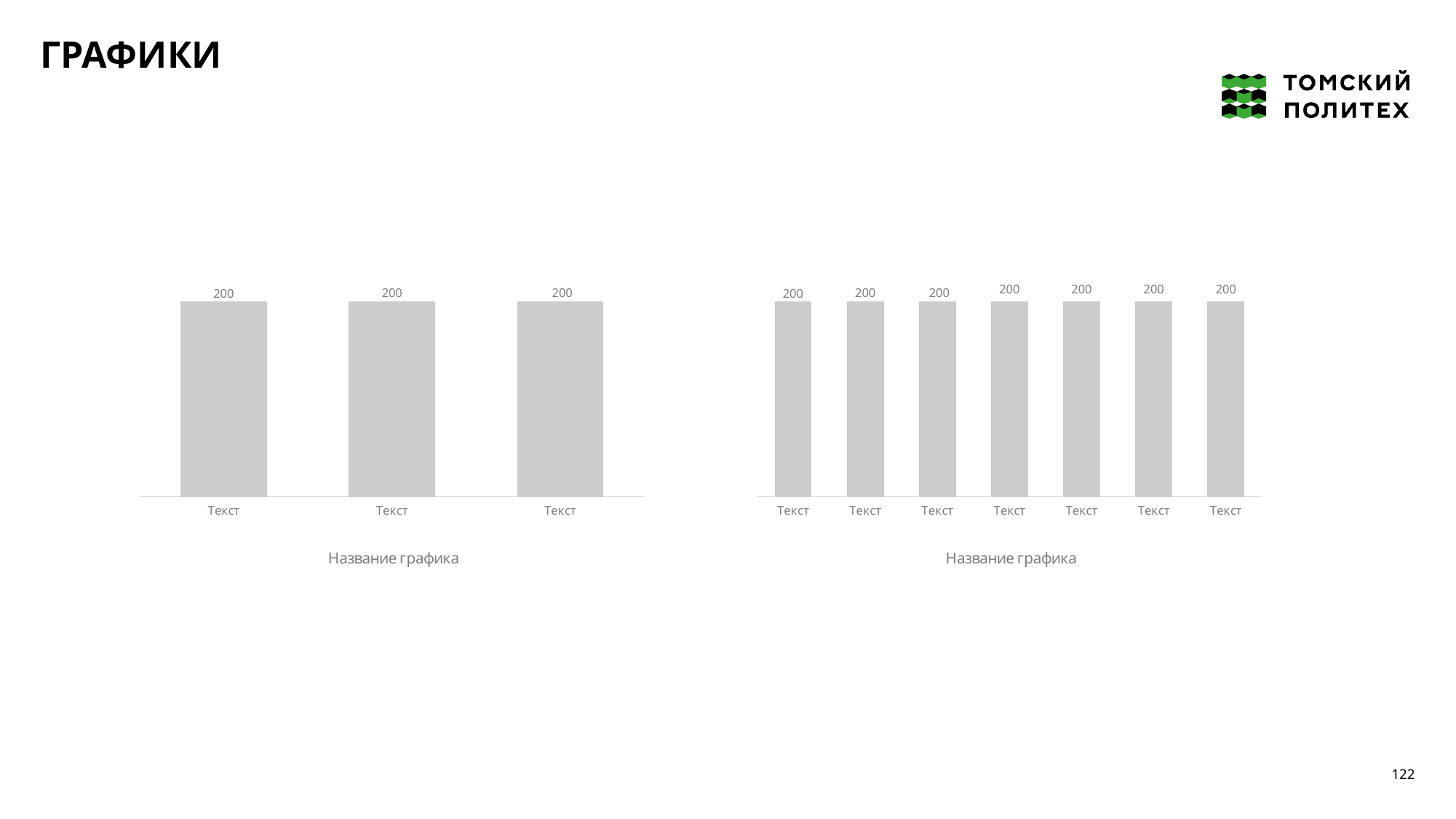
Do the values in the chart on the right side of the slide rise, fall, or stay flat from left to right? stay flat In the chart on the right side of the slide, what is the value of the fourth bar? 200 In the chart on the left side of the slide, what is the value of the first bar? 200 How many bars does the chart on the left side of the slide have? 3 How many bars does the chart on the right side of the slide have? 7 In the chart on the right side of the slide, what is the value of the last bar? 200 In the chart on the left side of the slide, what is the value of the third bar? 200 In the chart on the left side of the slide, what is the difference between the first and second bars? 0 What is the title shown under the chart on the left side of the slide? Название графика What kind of chart is the chart on the right side of the slide? bar chart What kind of chart is the chart on the left side of the slide? bar chart What label is used for every category on the x axis of the chart on the right side of the slide? Текст